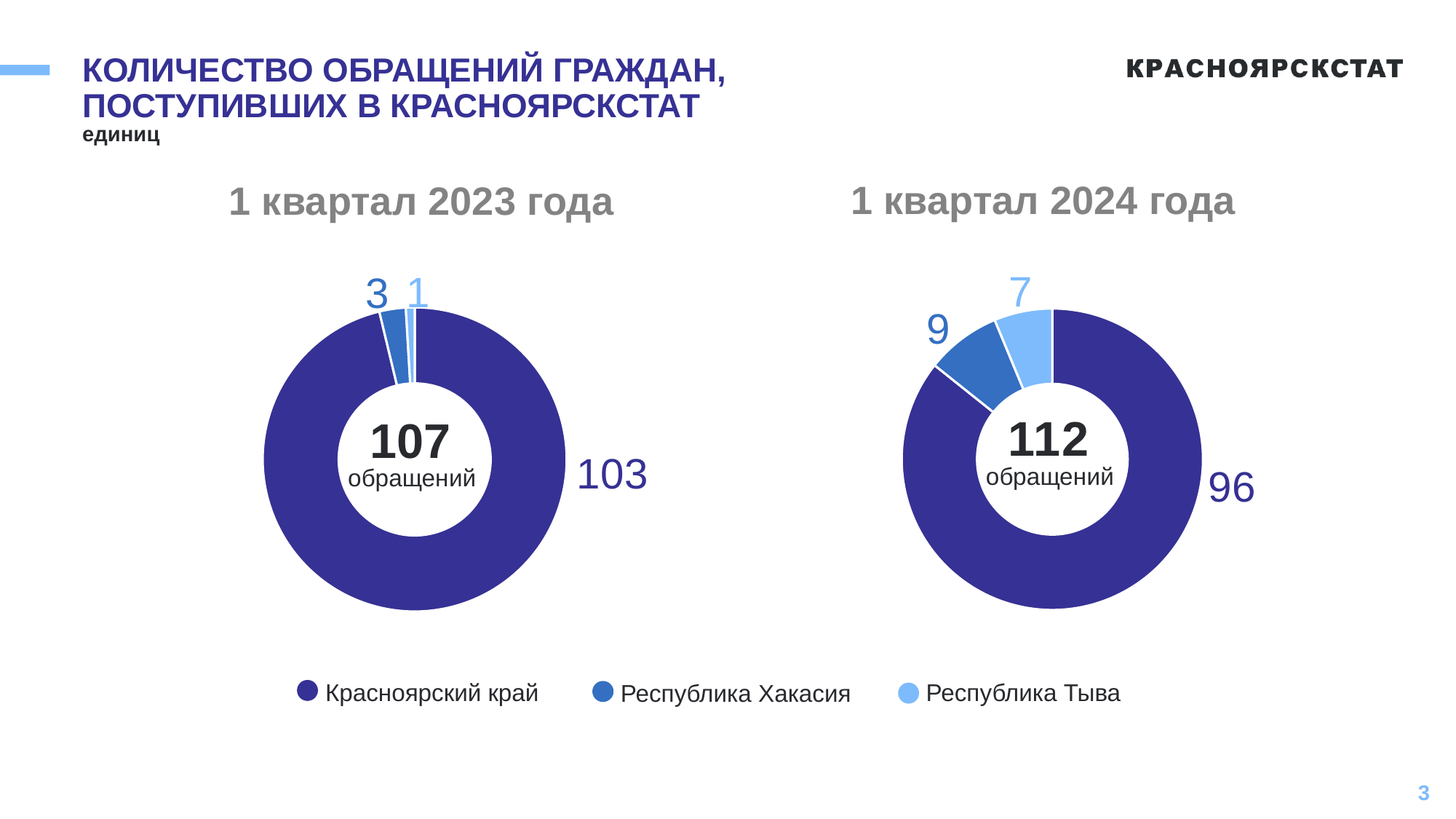
In the '1 квартал 2023 года' chart, what is the value for Республика Тыва? 1 In the '1 квартал 2024 года' chart, what is the value for Республика Тыва? 7 How many categories does the '1 квартал 2023 года' chart show? 3 In the '1 квартал 2023 года' chart, which category has the smallest value? Республика Тыва What is the total number of обращений shown in the centre of the '1 квартал 2024 года' chart? 112 What is the difference between the value for Красноярский край in the '1 квартал 2023 года' chart and in the '1 квартал 2024 года' chart? 7 Which is larger: the value for Республика Хакасия in the '1 квартал 2023 года' chart or in the '1 квартал 2024 года' chart? 1 квартал 2024 года In the '1 квартал 2024 года' chart, what is the value for Республика Хакасия? 9 What kind of chart is used on the slide? Pie (donut) chart How many entries does the legend list? 3 In the '1 квартал 2024 года' chart, which category has the largest value? Красноярский край In the '1 квартал 2023 года' chart, what is the value for Красноярский край? 103